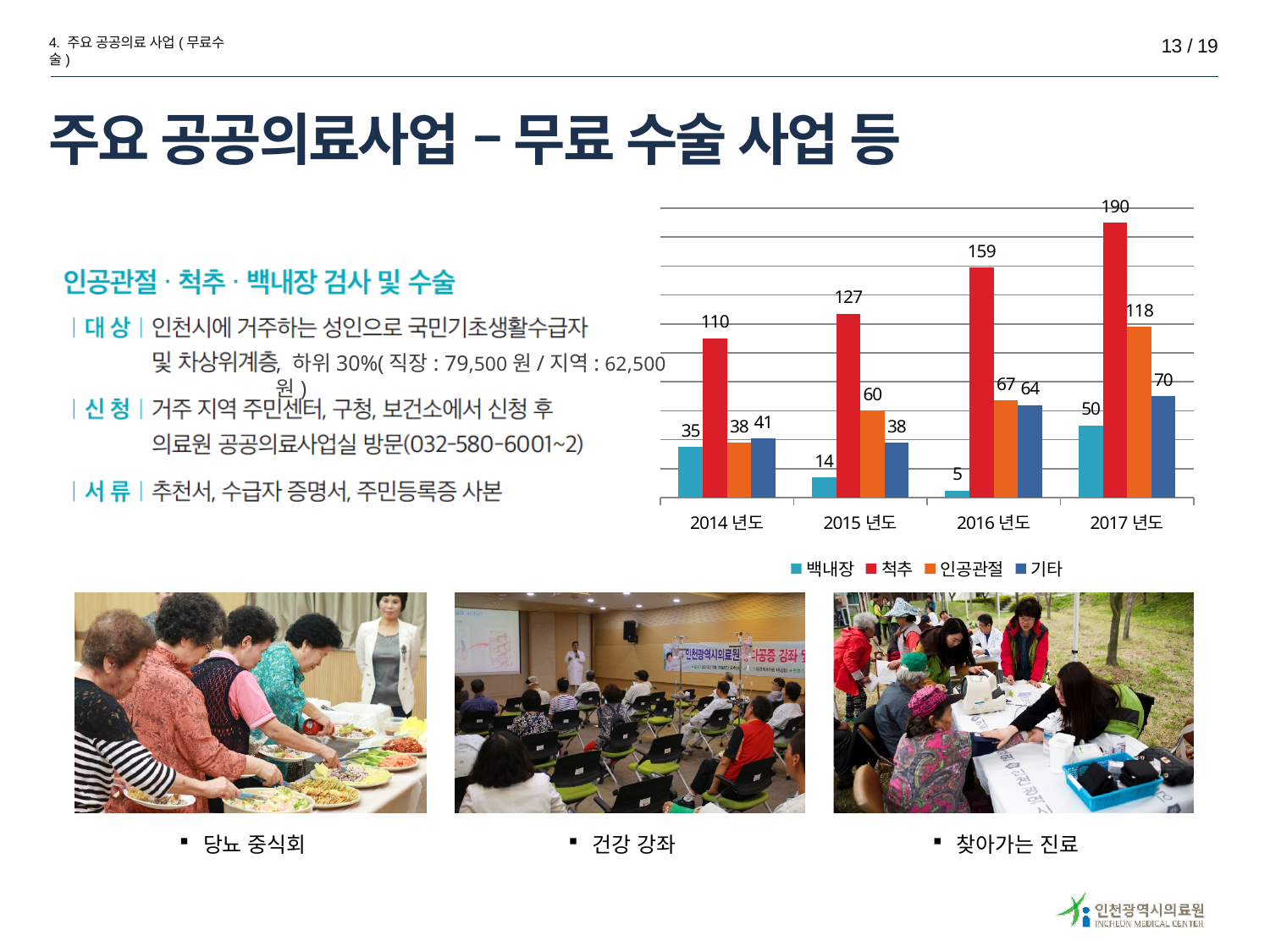
What is the difference between the 척추 values for 2017 년도 and 2016 년도? 31 What kind of chart is shown on the slide? Bar chart How many years are shown on the x axis? 4 Which is larger in 2016 년도, 인공관절 or 기타? 인공관절 In which year is the 백내장 value lowest? 2016 년도 What is the value for 척추 in 2017 년도? 190 What is the value for 백내장 in 2016 년도? 5 In which year is the 척추 value highest? 2017 년도 What is the value for 인공관절 in 2015 년도? 60 Does the 척추 value rise or fall from 2014 년도 to 2017 년도? Rise What is the value for 기타 in 2014 년도? 41 How many series does the legend list? 4